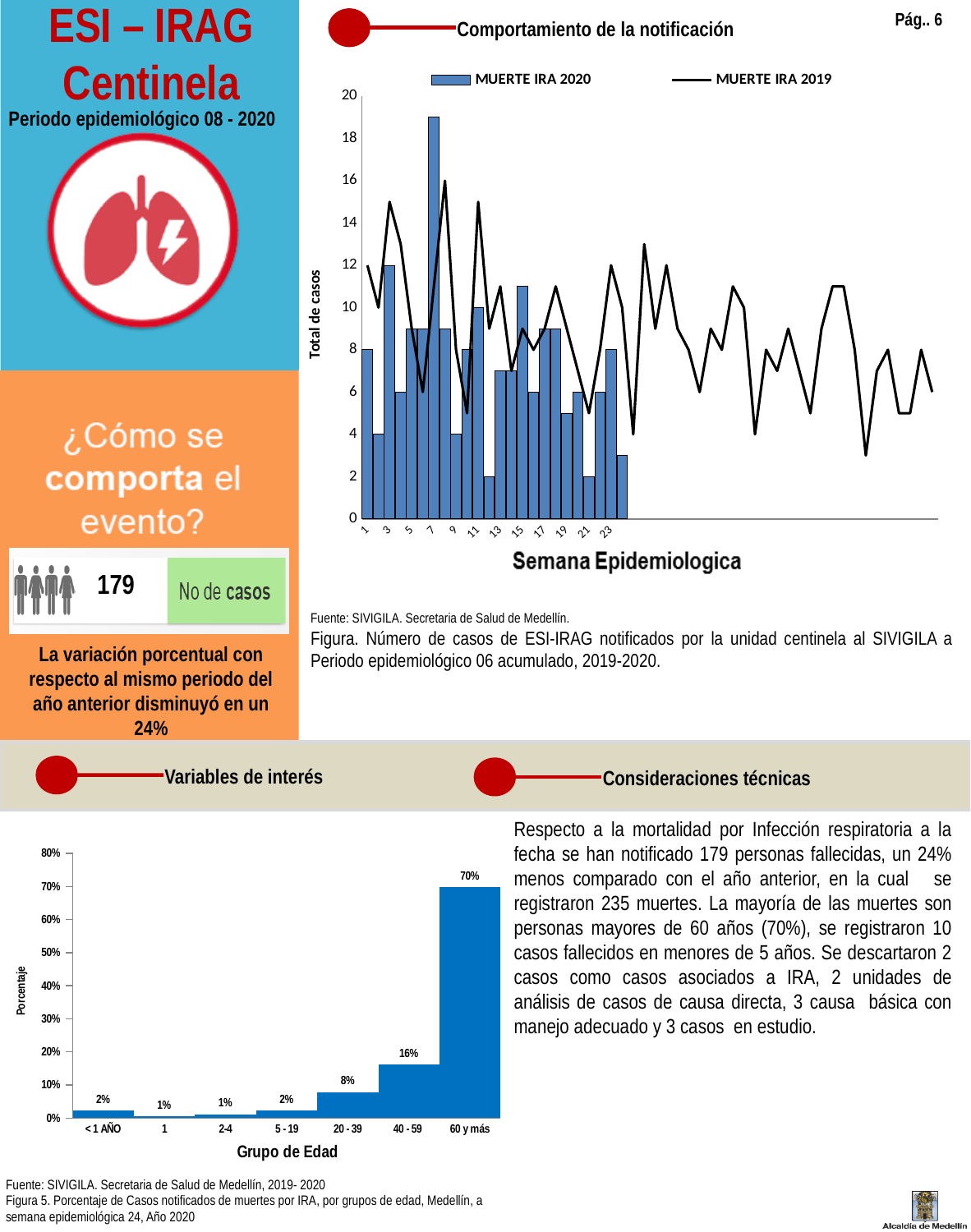
In the bottom chart by age group, what is the difference between the '60 y más' and '40 - 59' percentages? 54% In the top chart 'Comportamiento de la notificación', how many series does the legend list? 2 In the bottom chart by age group, what percentage is shown for the '20 - 39' group? 8% In the bottom chart by age group, which is larger: the value for '< 1 AÑO' or the value for '20 - 39'? 20 - 39 In the top chart 'Comportamiento de la notificación', is the MUERTE IRA 2020 bar for week 7 greater or less than 18? greater What kind of chart is the bottom chart by age group? Bar chart In the top chart 'Comportamiento de la notificación', what is the label of the y axis? Total de casos In the bottom chart by age group, which age group has the highest percentage? 60 y más In the top chart 'Comportamiento de la notificación', is the MUERTE IRA 2020 bar for week 12 greater or less than 4? less In the bottom chart by age group, what percentage is shown for the '60 y más' group? 70% In the bottom chart by age group, what percentage is shown for the '40 - 59' group? 16% In the bottom chart by age group, how many age groups are shown on the x axis? 7